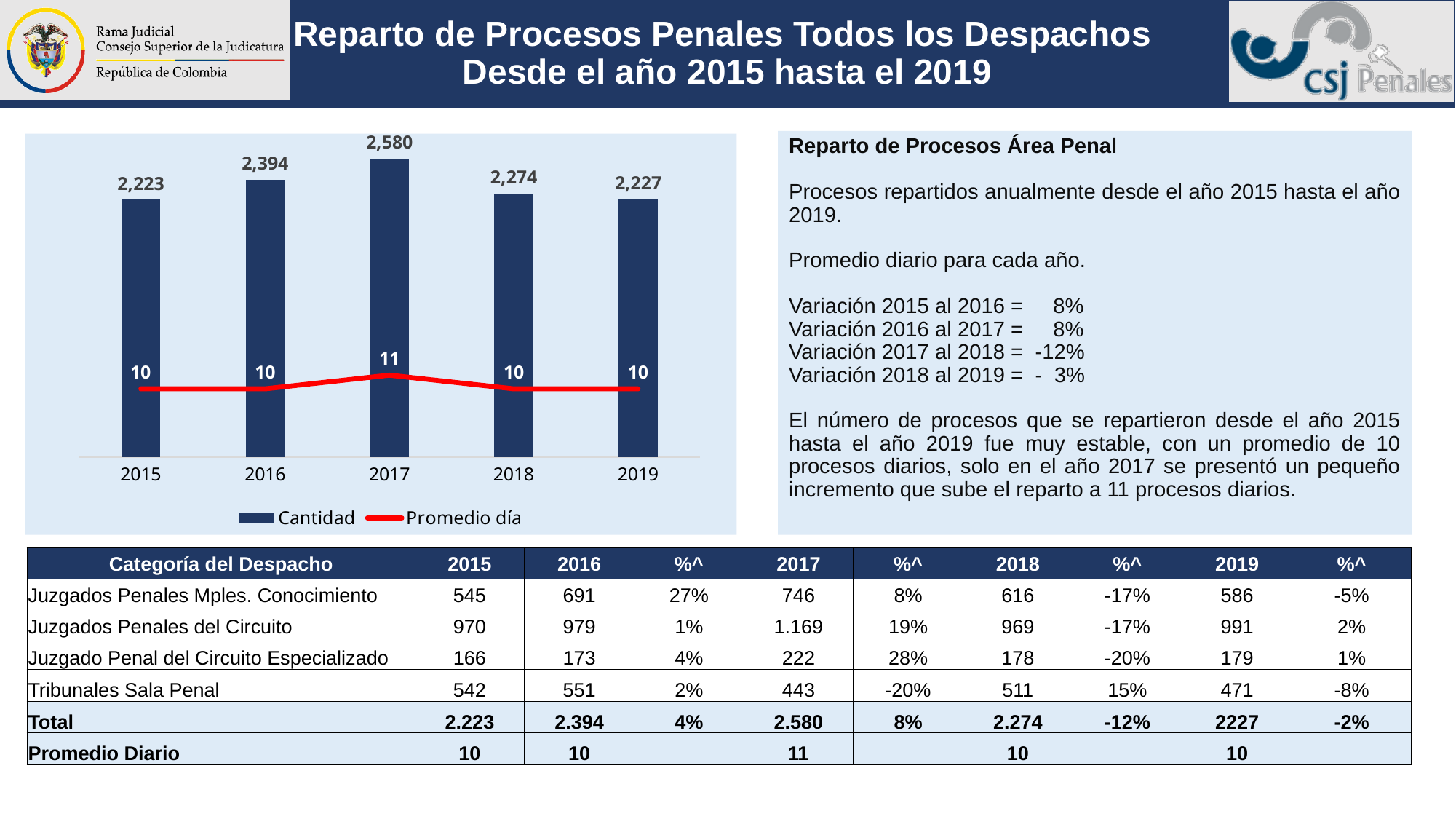
What is the Cantidad value for 2015? 2,223 What kind of chart is used to show the Cantidad series? Bar chart Which is larger, the Cantidad for 2018 or for 2019? 2018 What is the Cantidad value for 2017? 2,580 What is the difference between the Cantidad for 2017 and 2016? 186 Does the Cantidad rise or fall from 2017 to 2019? Fall How many series does the chart legend list? 2 How many years are shown on the x axis of the chart? 5 What is the Promedio día value for 2017? 11 What colour is the Promedio día line in the chart? Red Which year has the lowest Cantidad? 2015 Which year has the highest Cantidad? 2017